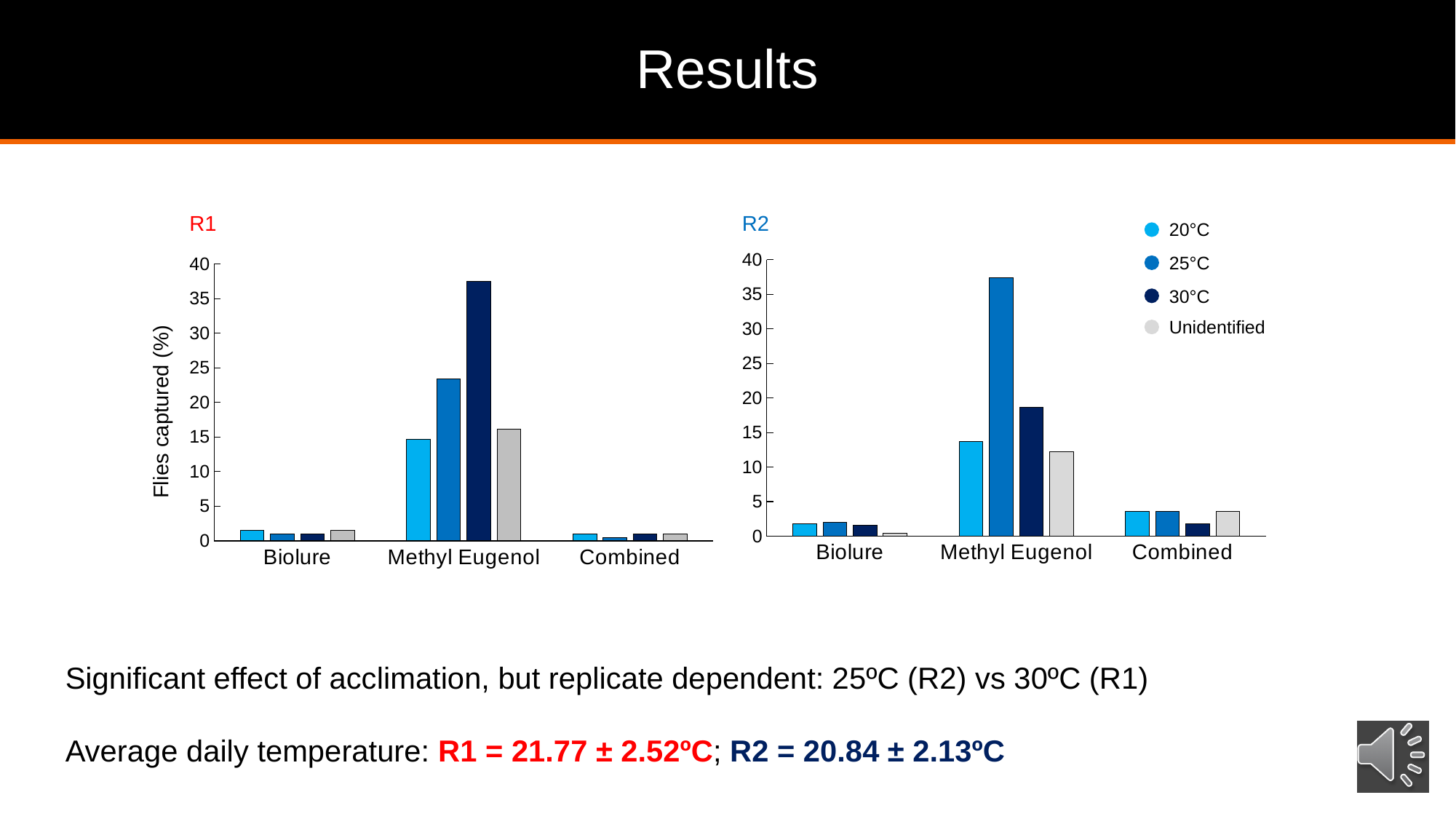
In the R1 chart, which lure category has the highest bars overall? Methyl Eugenol In the R2 chart, is the 25°C value for Methyl Eugenol greater or less than 35? greater In the R1 chart, which is larger for Methyl Eugenol: the 25°C bar or the 20°C bar? 25°C In the R2 chart, is the 30°C value for Methyl Eugenol greater or less than 20? less How many series does the legend list? 4 What is the y-axis label of the R1 chart? Flies captured (%) In the R1 chart, which temperature series has the highest bar for Methyl Eugenol? 30°C In the R2 chart, which is larger for Methyl Eugenol: the 30°C bar or the Unidentified bar? 30°C How many categories are shown on the x axis of the R2 chart? 3 In the R1 chart, is the 30°C value for Methyl Eugenol greater or less than 35? greater What kind of chart is the R1 chart? bar chart In the R2 chart, which temperature series has the highest bar for Methyl Eugenol? 25°C